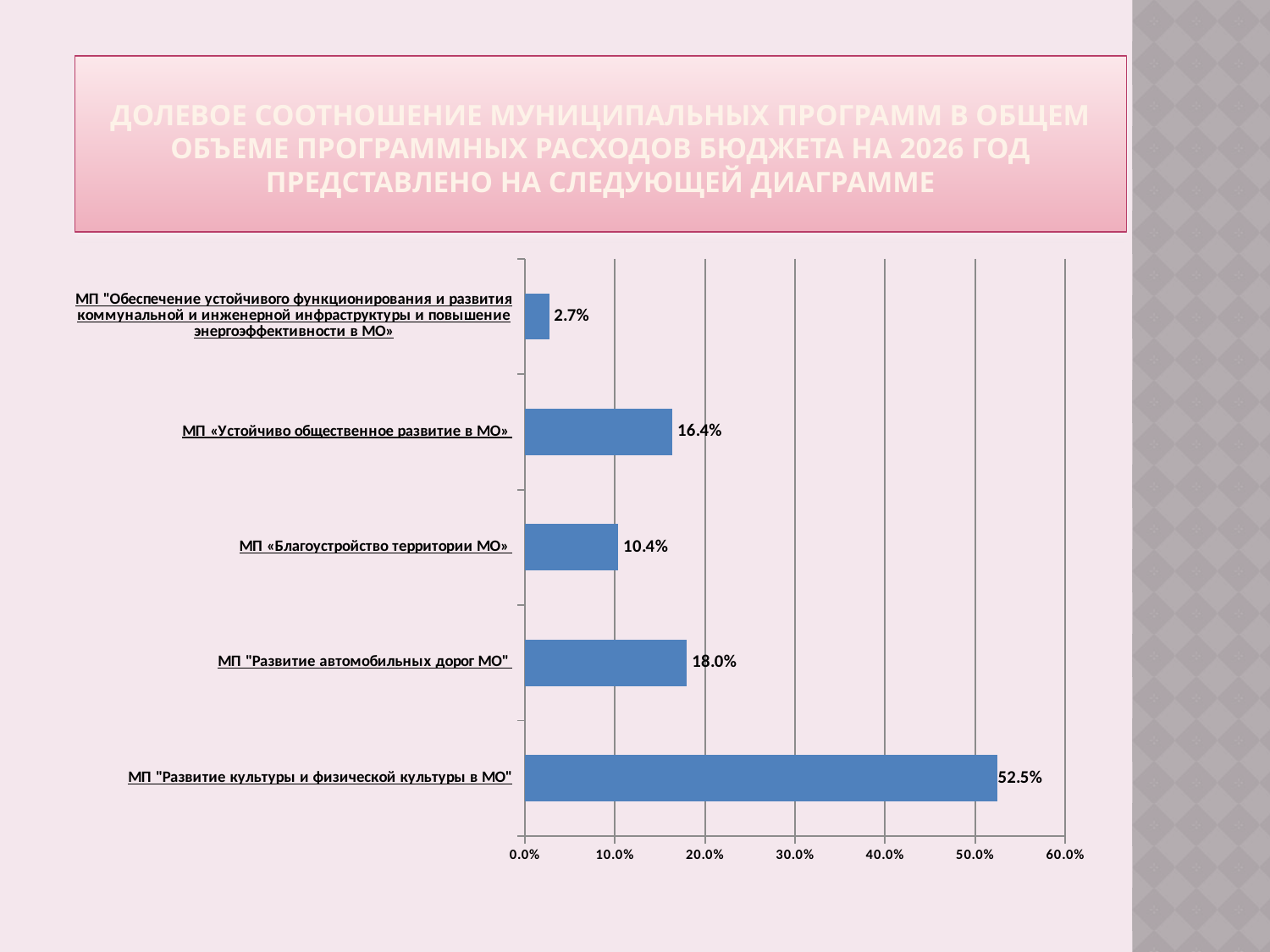
What is the value for МП "Развитие культуры и физической культуры в МО"? 52.5% Which program has the highest share? МП "Развитие культуры и физической культуры в МО" What is the value for МП "Развитие автомобильных дорог МО"? 18.0% Which program has the lowest share? МП "Обеспечение устойчивого функционирования и развития коммунальной и инженерной инфраструктуры и повышение энергоэффективности в МО» What kind of chart is shown on the slide? bar chart How many programs are shown in the chart? 5 Is the value for МП "Развитие культуры и физической культуры в МО" greater or less than 50.0%? greater Which is larger: the value for МП «Устойчиво общественное развитие в МО» or МП «Благоустройство территории МО»? МП «Устойчиво общественное развитие в МО» What is the difference between the values for МП "Развитие автомобильных дорог МО" and МП «Благоустройство территории МО»? 7.6% What is the value for МП «Устойчиво общественное развитие в МО»? 16.4% What is the value for МП «Благоустройство территории МО»? 10.4% What is the value for МП "Обеспечение устойчивого функционирования и развития коммунальной и инженерной инфраструктуры и повышение энергоэффективности в МО»? 2.7%